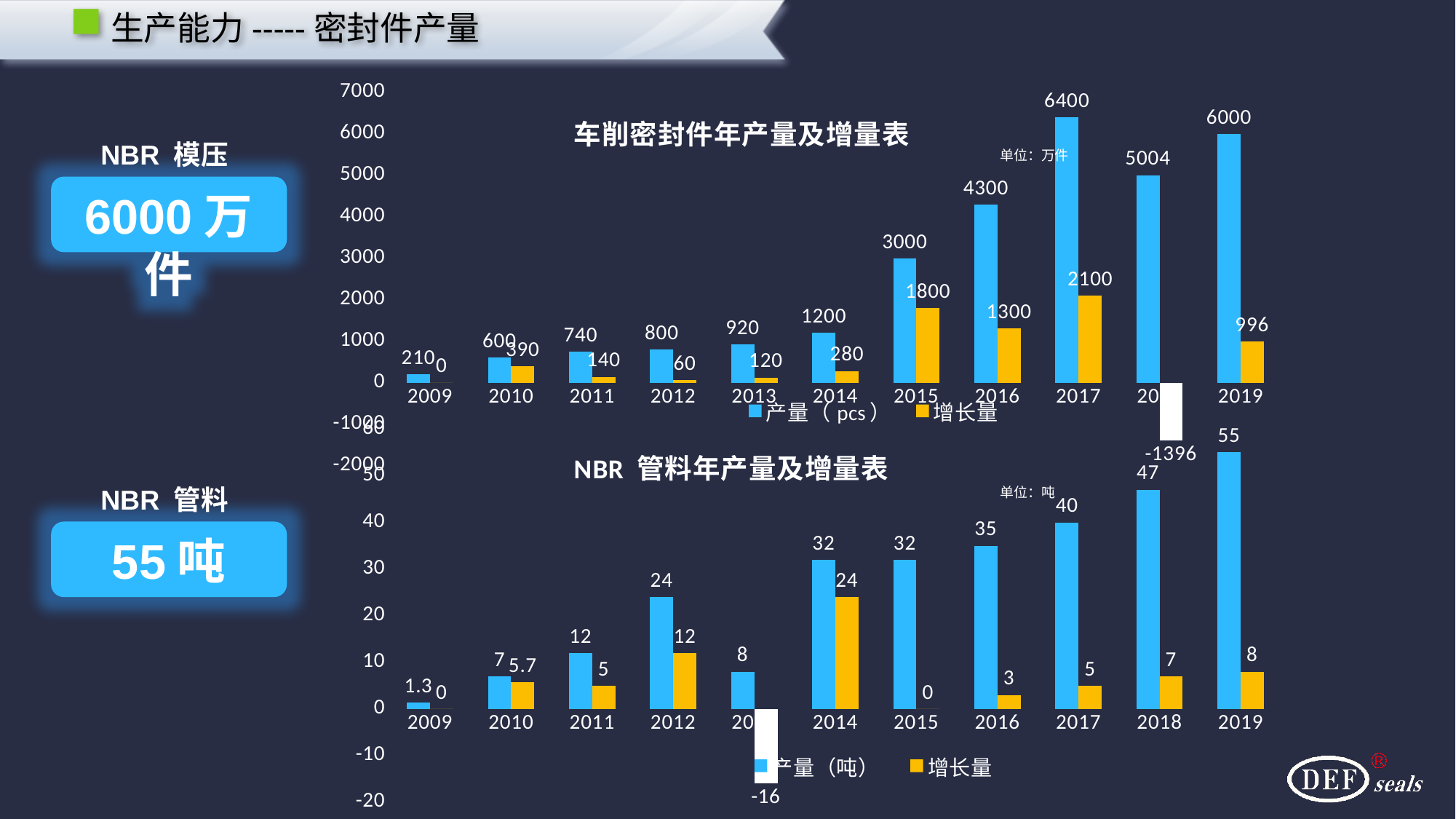
In the top chart (车削密封件年产量及增量表), how many years are shown on the x axis? 11 In the bottom chart (NBR 管料年产量及增量表), which is larger, the 产量 for 2012 or the 产量 for 2013? 2012 In the bottom chart (NBR 管料年产量及增量表), what is the 增长量 value for 2013? -16 In the top chart (车削密封件年产量及增量表), how many series does the legend list? 2 In the bottom chart (NBR 管料年产量及增量表), what is the 产量 value for 2019? 55 In the top chart (车削密封件年产量及增量表), what is the difference between the 产量 values for 2019 and 2018? 996 What unit is stated for the top chart (车削密封件年产量及增量表)? 万件 What kind of chart is the bottom chart (NBR 管料年产量及增量表)? Bar chart In the top chart (车削密封件年产量及增量表), what is the 产量 value for 2017? 6400 In the bottom chart (NBR 管料年产量及增量表), which year has the lowest 产量? 2009 In the top chart (车削密封件年产量及增量表), what is the 增长量 value for 2018? -1396 In the top chart (车削密封件年产量及增量表), which year has the highest 产量? 2017